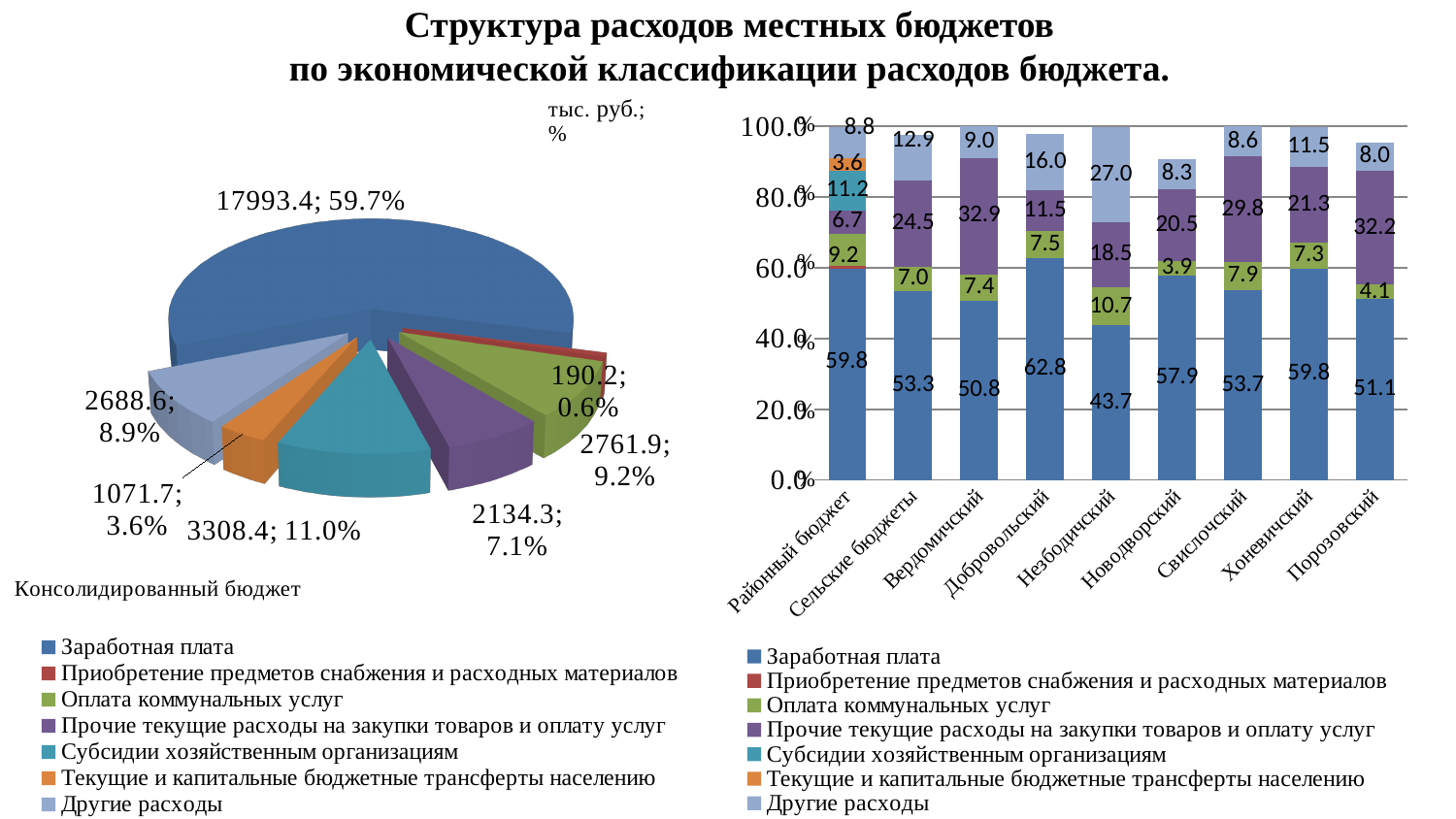
In the pie chart (Консолидированный бюджет), what value in тыс. руб. is shown for Субсидии хозяйственным организациям? 3308.4 In the pie chart (Консолидированный бюджет), what is the share of Другие расходы? 8.9% In the stacked bar chart on the right, how many categories are shown on the x axis? 9 In the stacked bar chart on the right, what is the value of Прочие текущие расходы на закупки товаров и оплату услуг for Вердомичский? 32.9 In the pie chart (Консолидированный бюджет), which category has the smallest slice? Приобретение предметов снабжения и расходных материалов In the pie chart (Консолидированный бюджет), how many categories does the legend list? 7 In the stacked bar chart on the right, which is larger: Оплата коммунальных услуг for Районный бюджет or for Новодворский? Районный бюджет In the stacked bar chart on the right, what is the value of Заработная плата for Незбодичский? 43.7 In the pie chart (Консолидированный бюджет), what is the share of Заработная плата? 59.7% What type of chart is shown on the right side of the slide? Stacked bar chart In the stacked bar chart on the right, what is the difference between the Заработная плата values for Добровольский and Незбодичский? 19.1 In the stacked bar chart on the right, which category has the highest value for Другие расходы? Незбодичский